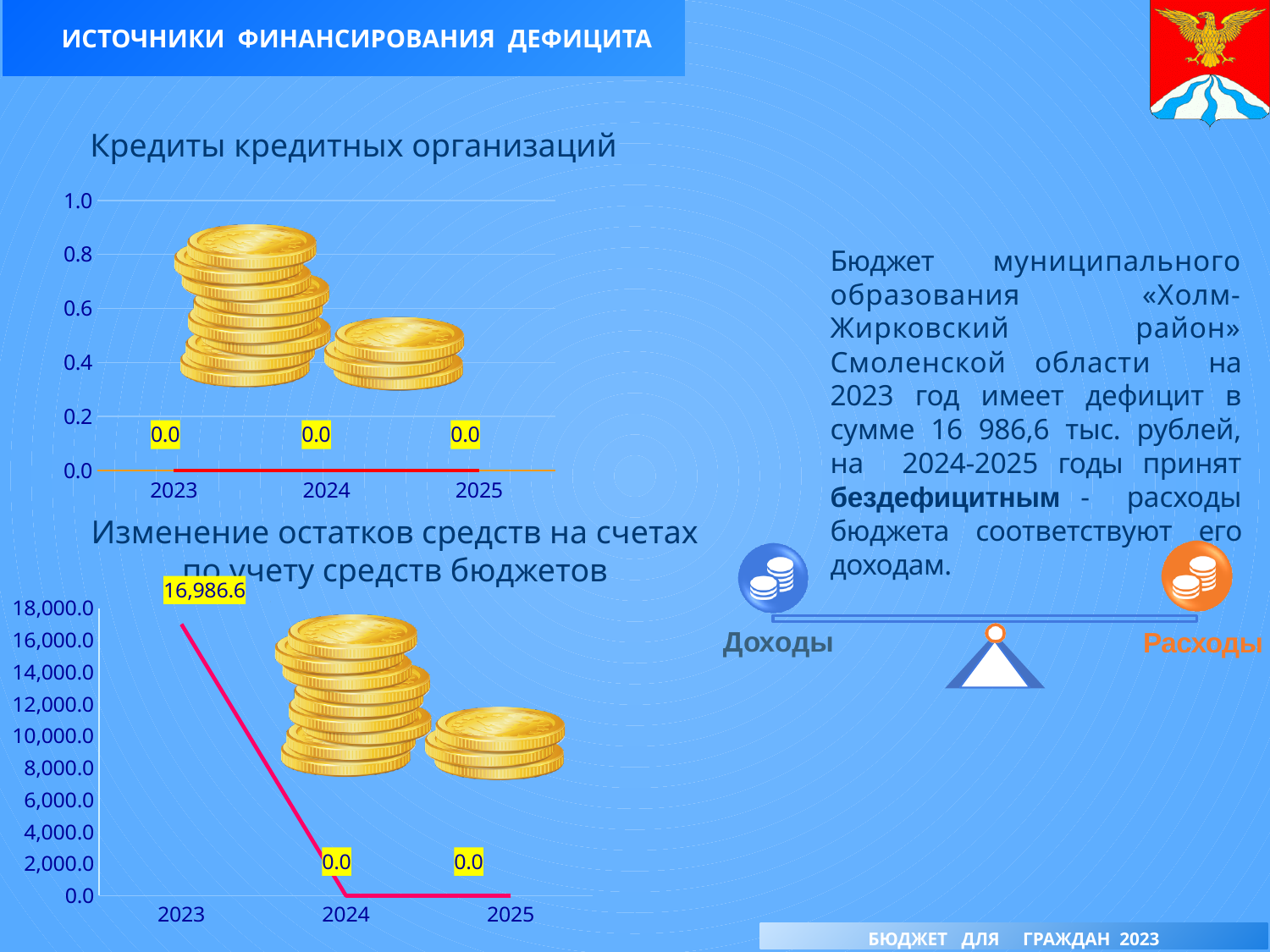
In the chart 'Кредиты кредитных организаций', what is the highest value shown on the y axis? 1.0 In the chart 'Изменение остатков средств на счетах по учету средств бюджетов', is the value for 2023 greater or less than 16,000.0? greater What kind of chart is 'Изменение остатков средств на счетах по учету средств бюджетов'? line chart What kind of chart is 'Кредиты кредитных организаций'? line chart In the chart 'Изменение остатков средств на счетах по учету средств бюджетов', what is the difference between the 2023 value and the 2024 value? 16,986.6 In the chart 'Изменение остатков средств на счетах по учету средств бюджетов', do the values rise or fall from 2023 to 2025? fall In the chart 'Кредиты кредитных организаций', what is the value for 2024? 0.0 In the chart 'Изменение остатков средств на счетах по учету средств бюджетов', what is the value for 2025? 0.0 In the chart 'Изменение остатков средств на счетах по учету средств бюджетов', which year has the highest value? 2023 In the chart 'Изменение остатков средств на счетах по учету средств бюджетов', what is the value for 2023? 16,986.6 In the chart 'Изменение остатков средств на счетах по учету средств бюджетов', which is larger: the value for 2023 or the value for 2024? 2023 In the chart 'Кредиты кредитных организаций', how many years are plotted on the x axis? 3